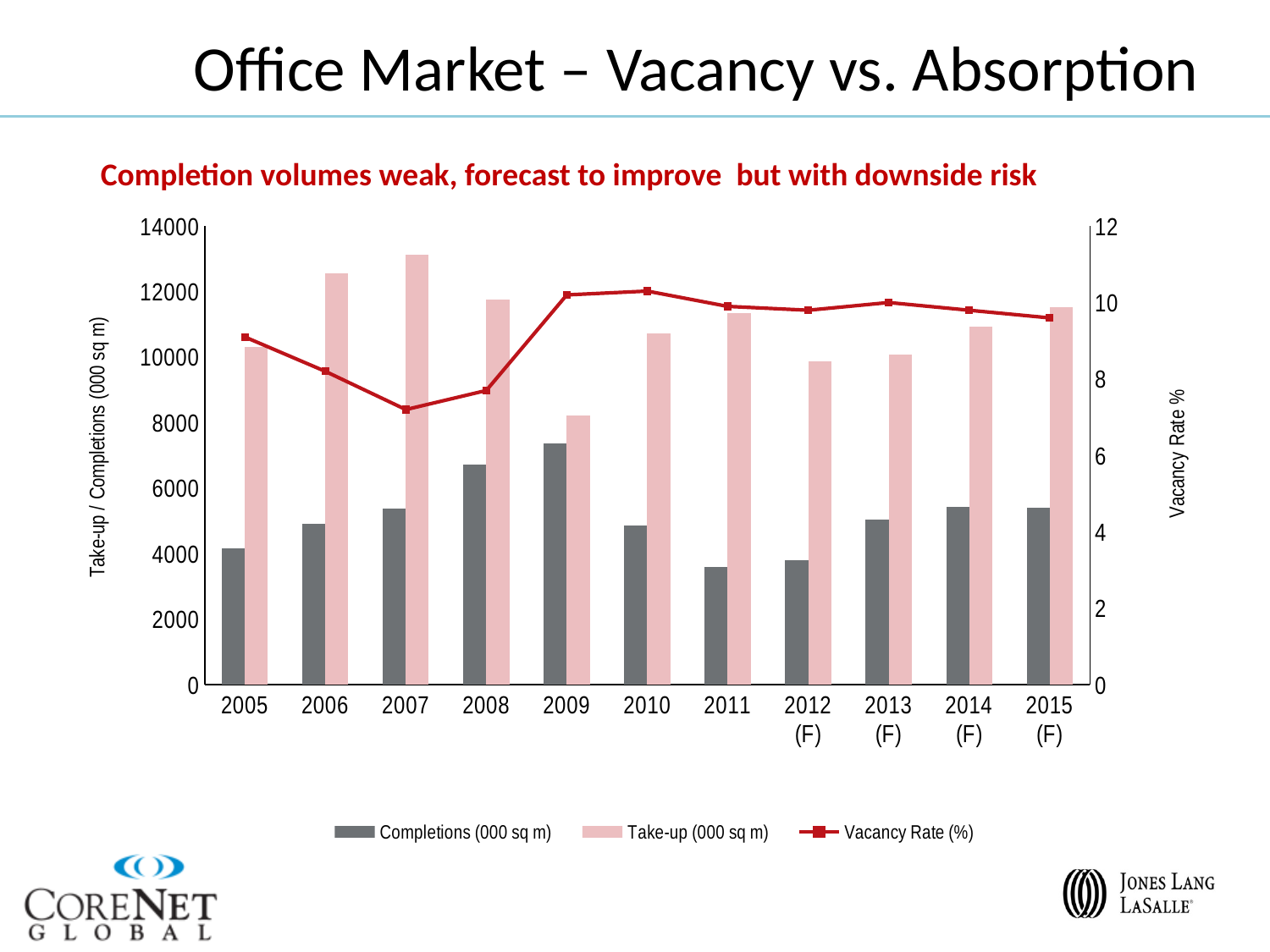
Which year has the larger Take-up, 2006 or 2008? 2006 How many series does the legend list? 3 Which year has the lowest Vacancy Rate (%)? 2007 Which year has the highest Completions (000 sq m)? 2009 Does the Vacancy Rate rise or fall from 2005 to 2007? Fall How many years are shown on the x axis? 11 Which year has the highest Take-up (000 sq m)? 2007 What kind of chart is this? Combination bar and line chart Which year has the lowest Take-up (000 sq m)? 2009 Is the Vacancy Rate for 2007 greater or less than 8? less Is the Completions value for 2009 greater or less than 6000? greater Is the Take-up value for 2007 greater or less than 12000? greater